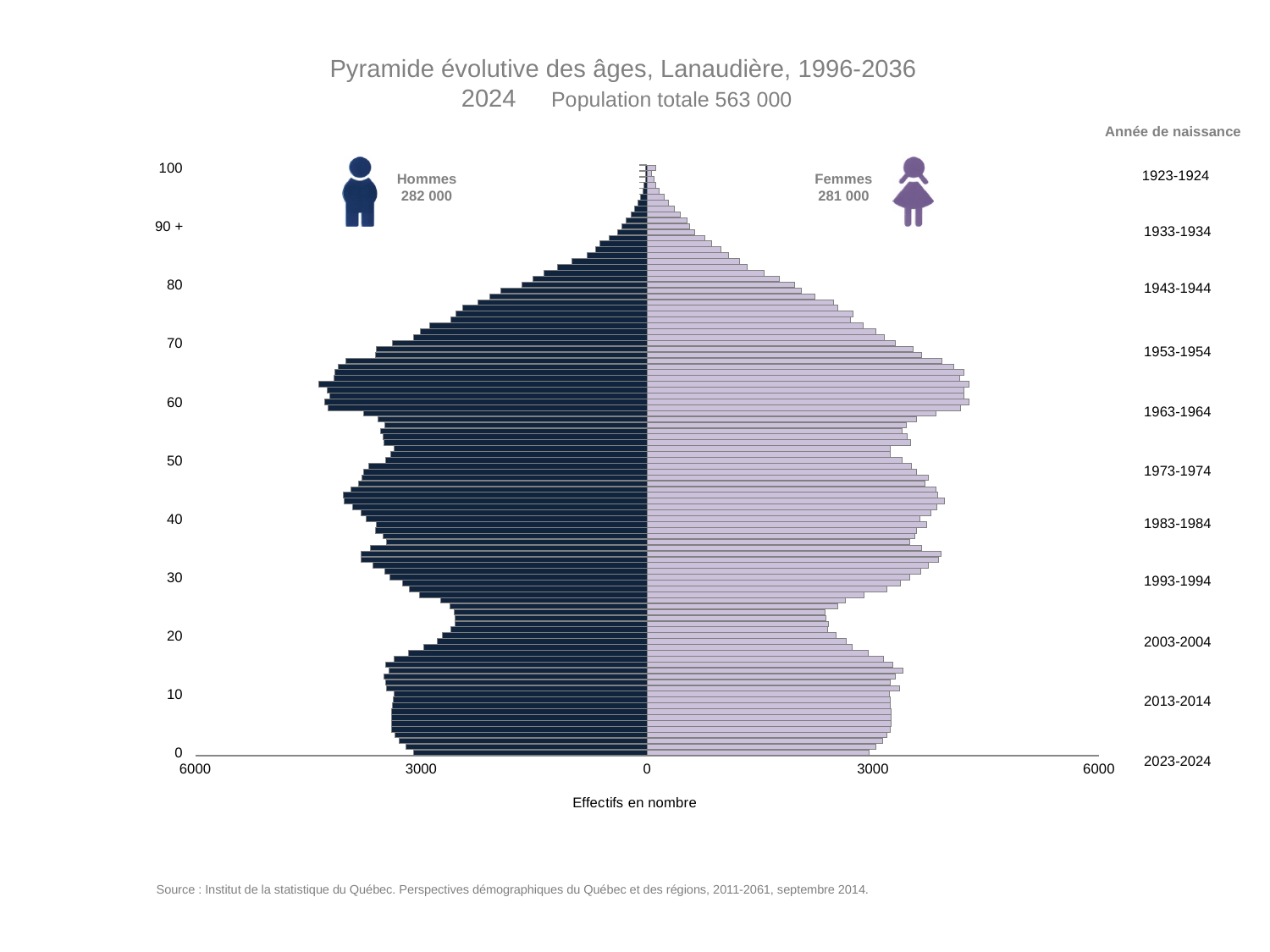
How many population groups (series) does the pyramid show? 2 From age 65 up to age 100, do the bar lengths for Hommes rise or fall? fall Which group is larger, Hommes or Femmes? Hommes What is the label of the horizontal axis? Effectifs en nombre What is the number of Hommes (men) shown on the pyramid? 282 000 Is the number of Femmes aged about 80 greater or less than 3000? less Is the number of Hommes aged about 90 greater or less than 3000? less What is the difference between the number of Hommes and the number of Femmes? 1 000 What is the total population shown for Lanaudière in 2024? 563 000 What is the number of Femmes (women) shown on the pyramid? 281 000 Is the number of Hommes aged about 63 greater or less than 3000? greater What kind of chart is shown on the slide? Bar chart (population pyramid)